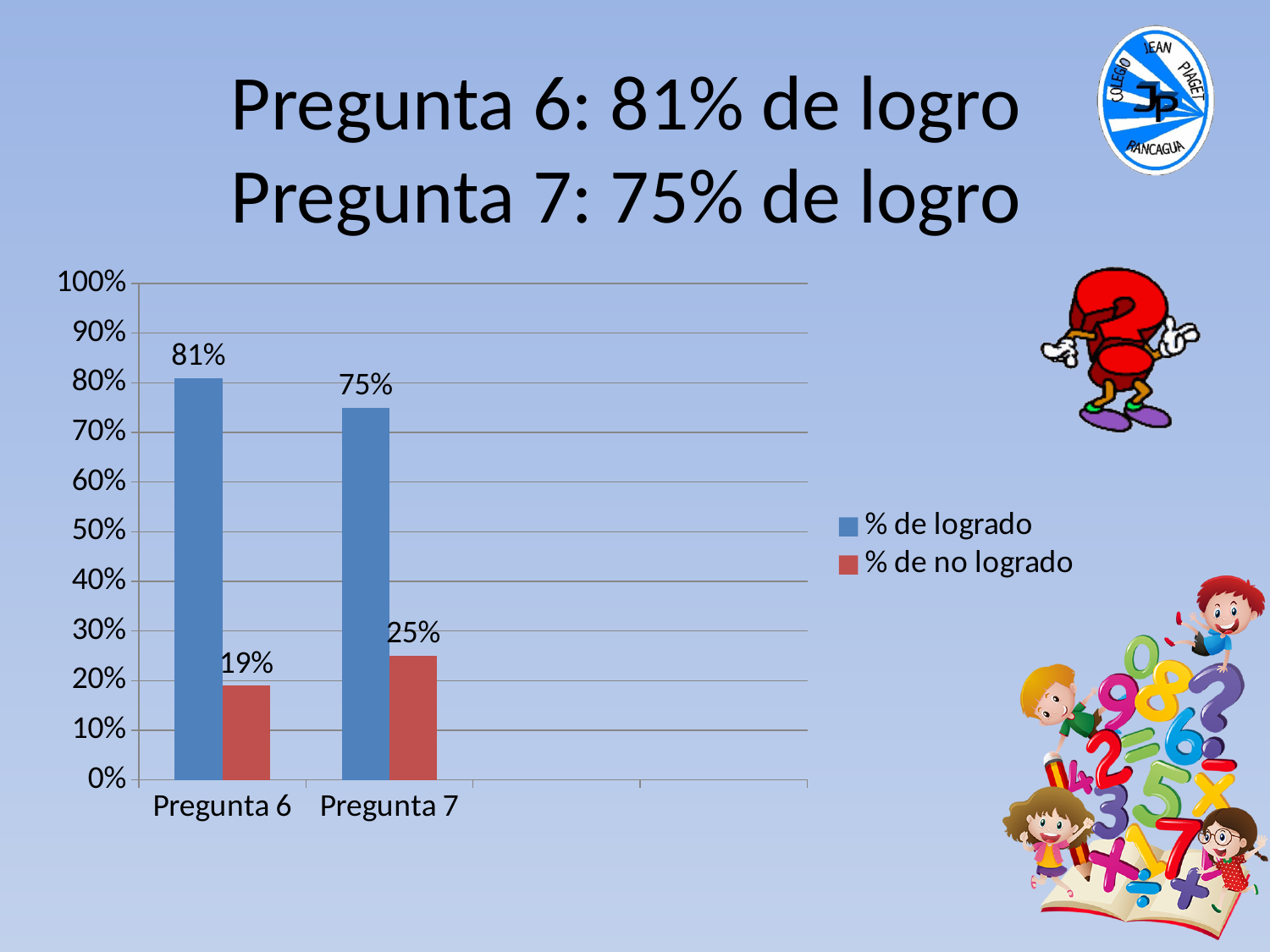
How many series does the legend list? 2 Which is larger: "% de no logrado" for Pregunta 6 or for Pregunta 7? Pregunta 7 What is the value of "% de no logrado" for Pregunta 7? 25% What is the difference between the "% de logrado" values for Pregunta 6 and Pregunta 7? 6% Is the "% de logrado" value for Pregunta 7 greater or less than 70%? greater Which category has the lowest "% de no logrado" value? Pregunta 6 How many categories are shown on the x axis? 2 What kind of chart is shown on the slide? Bar chart Which category has the highest "% de logrado" value? Pregunta 6 What is the value of "% de logrado" for Pregunta 6? 81% What is the value of "% de no logrado" for Pregunta 6? 19% What is the value of "% de logrado" for Pregunta 7? 75%